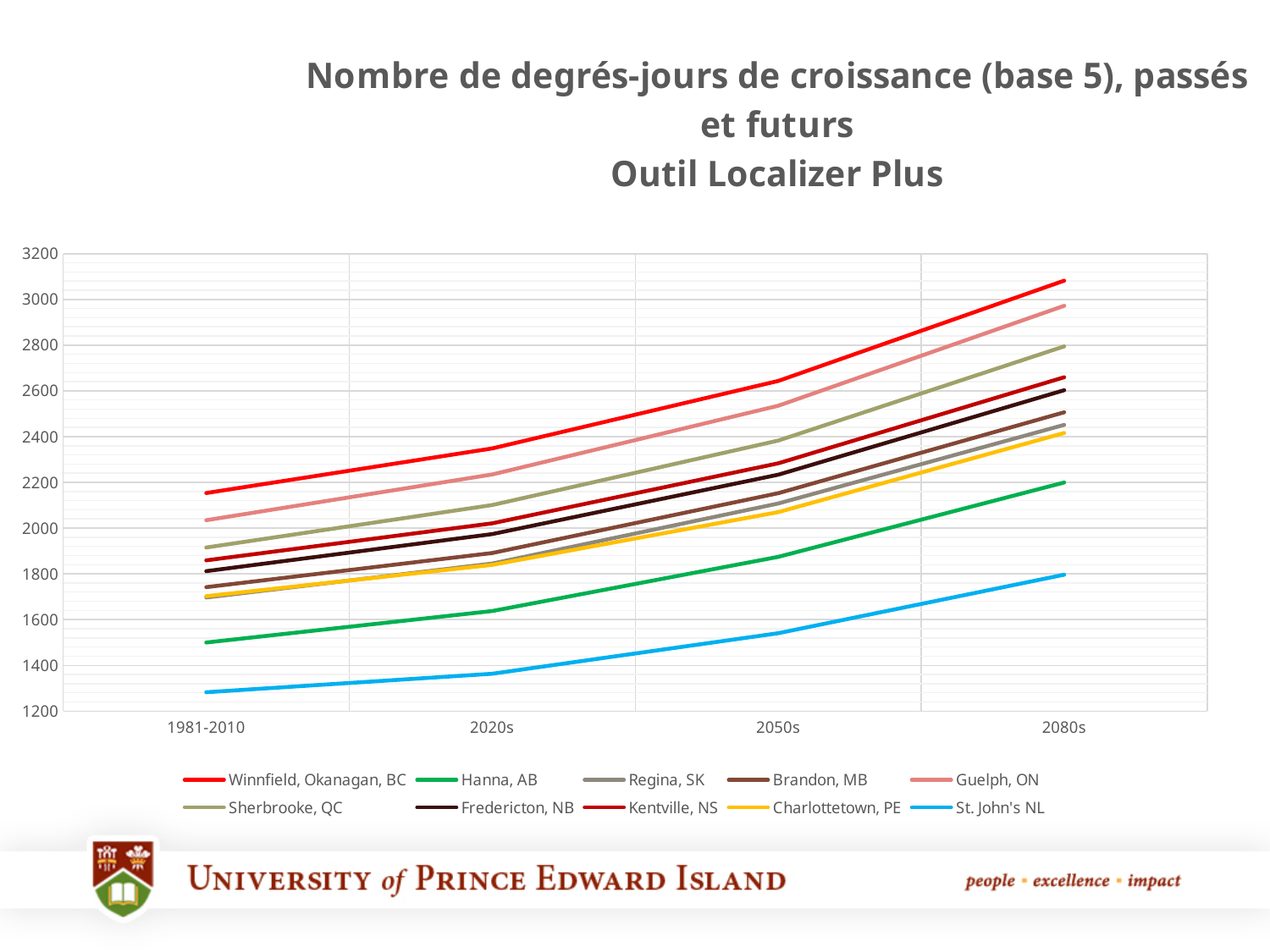
In the 2050s, which is larger: the value for Guelph, ON or the value for Hanna, AB? Guelph, ON How many series does the legend list? 10 Which tool is named in the chart title? Outil Localizer Plus Is the value for Winnfield, Okanagan, BC in the 2080s greater or less than 2800? greater In the 2080s, which is larger: the value for Sherbrooke, QC or the value for Fredericton, NB? Sherbrooke, QC Do the values for St. John's NL rise or fall from 1981-2010 to the 2080s? rise Is the value for Hanna, AB in 1981-2010 greater or less than 1600? less How many periods are shown along the x axis? 4 Which location has the lowest value in the 2080s? St. John's NL What kind of chart is shown on the slide? line chart Is the value for St. John's NL in the 2080s greater or less than 2000? less Which location has the highest value in the 2080s? Winnfield, Okanagan, BC